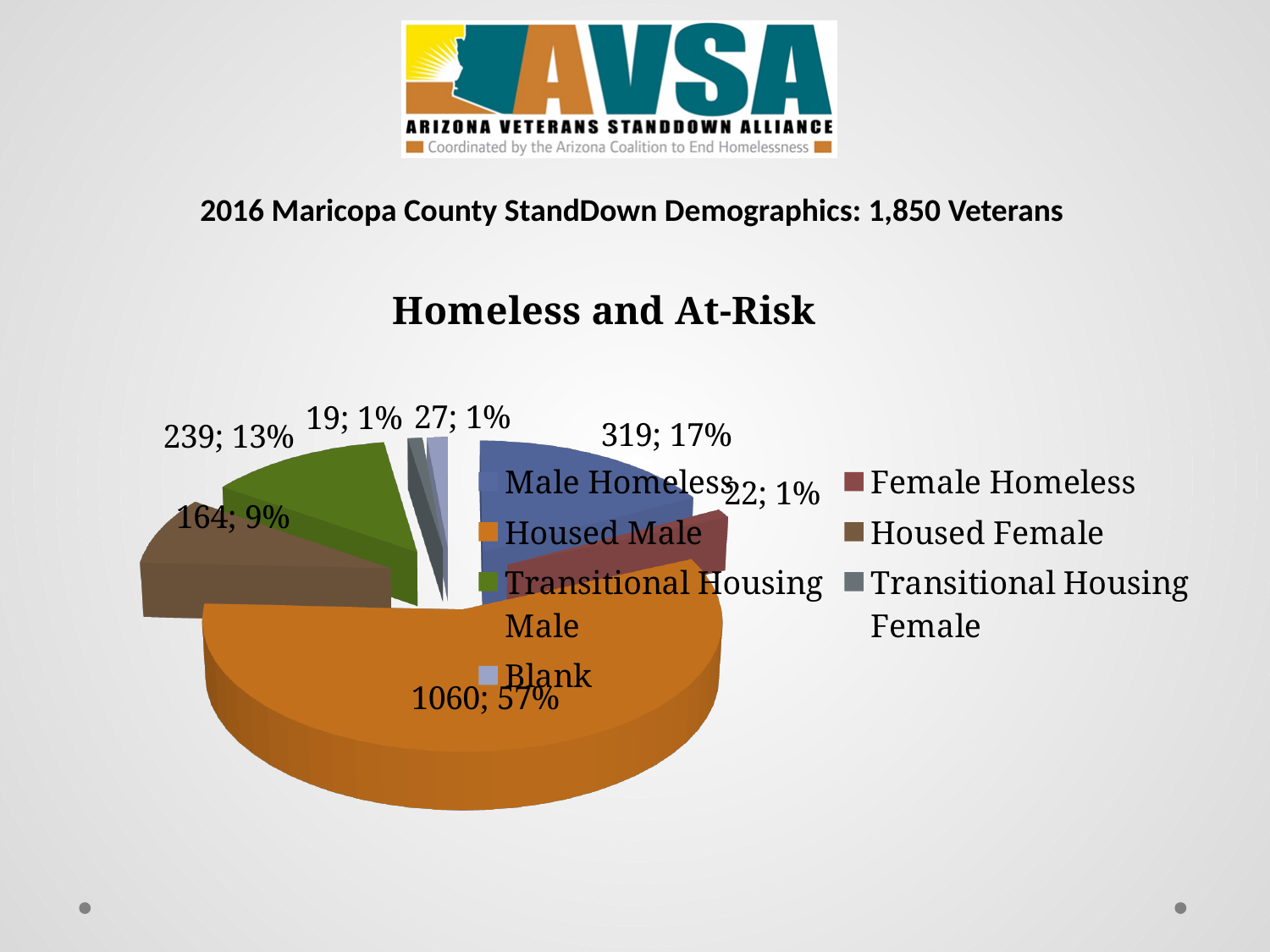
What is the value for Housed Female? 164 What share of the pie does Housed Male represent? 57% What is the value for Housed Male? 1060 What kind of chart is shown on the slide? pie chart What is the value for Male Homeless? 319 Which category has the smallest slice? Transitional Housing Female Which category has the largest slice? Housed Male Which is larger, the value for Female Homeless or the value for Blank? Blank What is the difference between the values for Male Homeless and Housed Female? 155 How many categories does the legend list? 7 What is the title of the chart? Homeless and At-Risk What is the value for Transitional Housing Male? 239